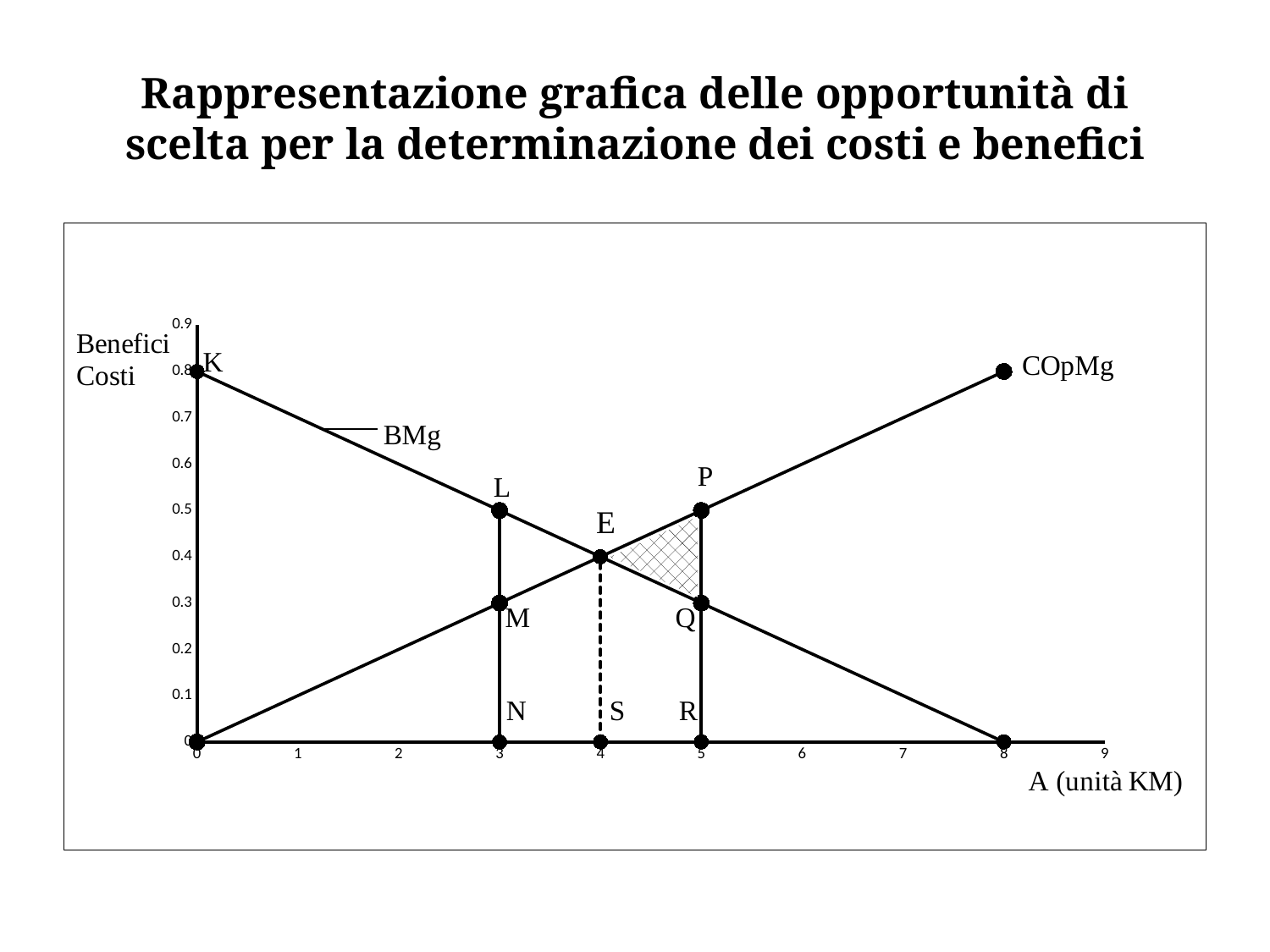
What is the difference between the values at points P and Q (A = 5)? 0.2 What is the value of BMg at point E, where A = 4? 0.4 What is the label of the horizontal axis? A (unità KM) Does the COpMg line rise or fall as A increases? rise At A = 5, which line is higher, BMg or COpMg? COpMg What is the value of COpMg at point P, where A = 5? 0.5 What is the value of BMg at point Q, where A = 5? 0.3 At A = 3, which line is higher, BMg or COpMg? BMg Does the BMg line rise or fall as A increases? fall What kind of chart is shown on the slide? line chart Is the value of BMg at A = 2 greater or less than 0.5? greater What is the value of BMg at point K, where A = 0? 0.8